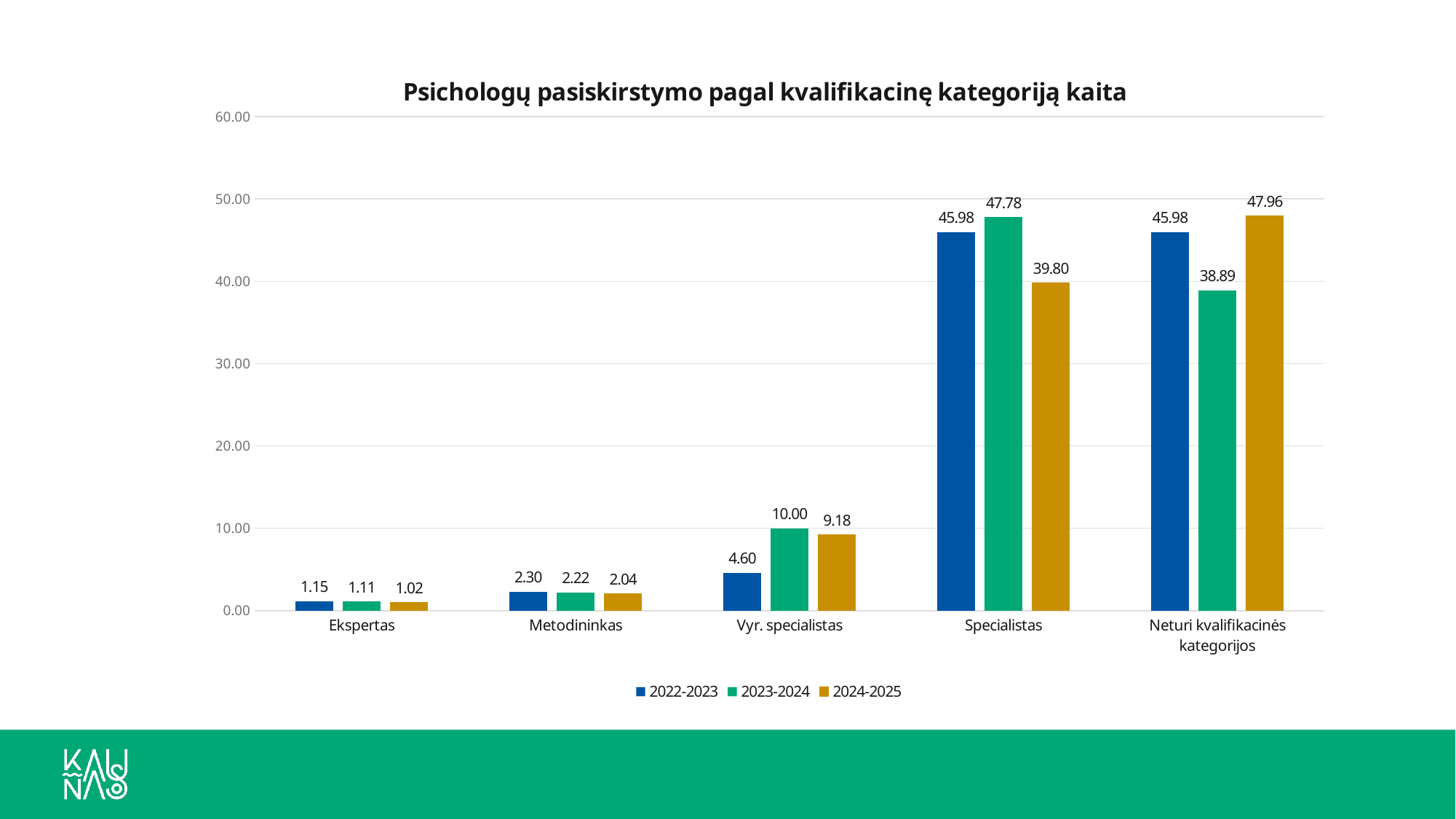
Which is larger for Neturi kvalifikacinės kategorijos: the 2022-2023 value or the 2023-2024 value? 2022-2023 Which category has the highest value in the 2023-2024 series? Specialistas What is the value for Specialistas in the 2023-2024 series? 47.78 What is the value for Vyr. specialistas in the 2022-2023 series? 4.60 What is the title of the chart? Psichologų pasiskirstymo pagal kvalifikacinę kategoriją kaita Which category has the lowest value in the 2024-2025 series? Ekspertas Do the values for Vyr. specialistas rise or fall from 2022-2023 to 2023-2024? Rise How many series does the legend list? 3 What is the value for Neturi kvalifikacinės kategorijos in the 2024-2025 series? 47.96 How many categories are shown on the x axis? 5 What is the difference between the 2023-2024 and 2024-2025 values for Specialistas? 7.98 What kind of chart is shown on the slide? Bar chart